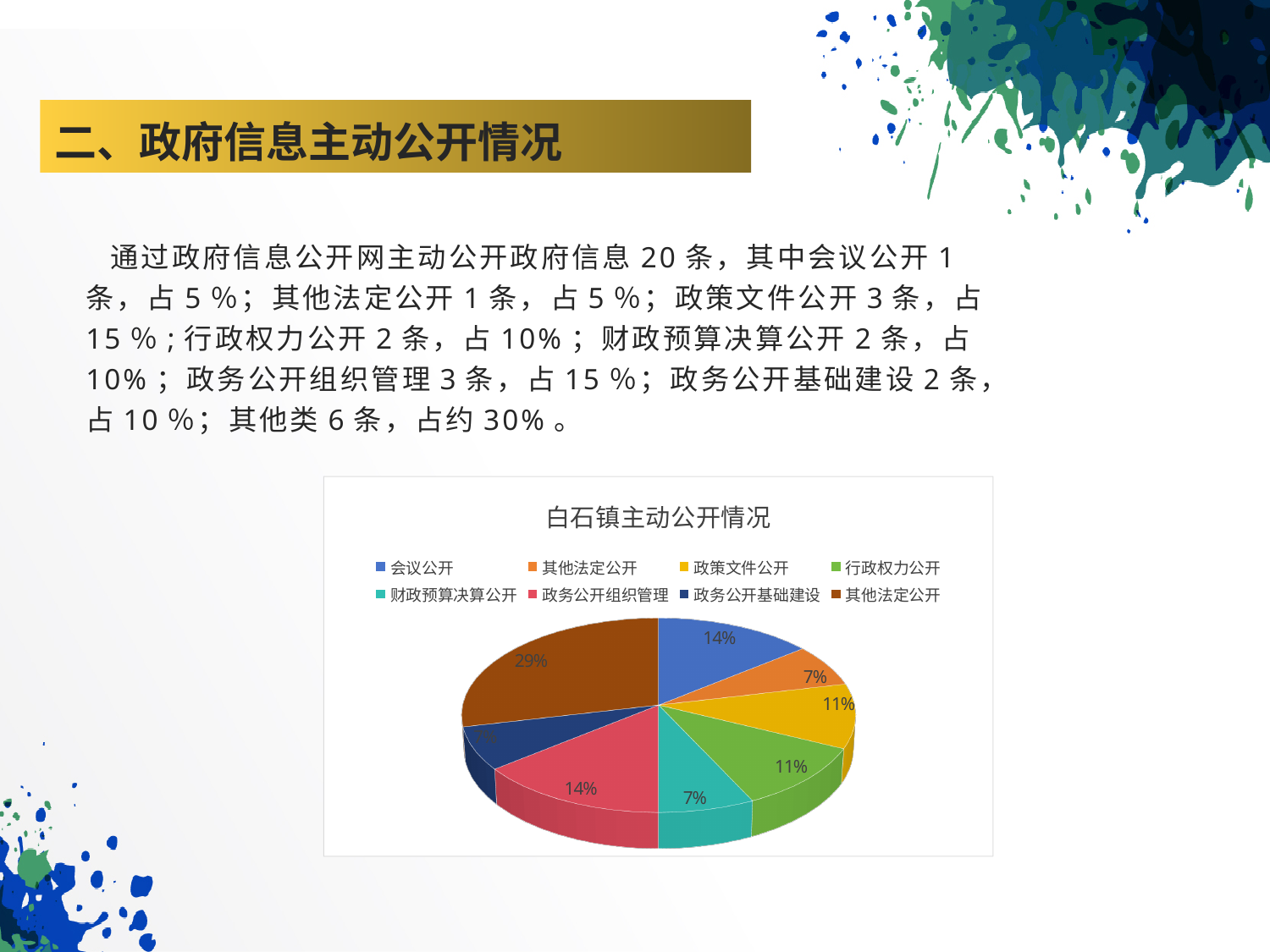
What share of the pie does 政务公开组织管理 account for? 14% How many slices does the pie chart have? 8 How many entries does the chart's legend list? 8 What share of the pie does 财政预算决算公开 account for? 7% Which has the larger share, 会议公开 or 财政预算决算公开? 会议公开 What share of the pie does 政策文件公开 account for? 11% What share of the pie does 行政权力公开 account for? 11% What is the largest share shown on the pie chart? 29% What kind of chart is shown on the slide? pie chart What share of the pie does 会议公开 account for? 14% What is the title of the chart? 白石镇主动公开情况 How much larger is the share of 政务公开组织管理 than that of 财政预算决算公开? 7%